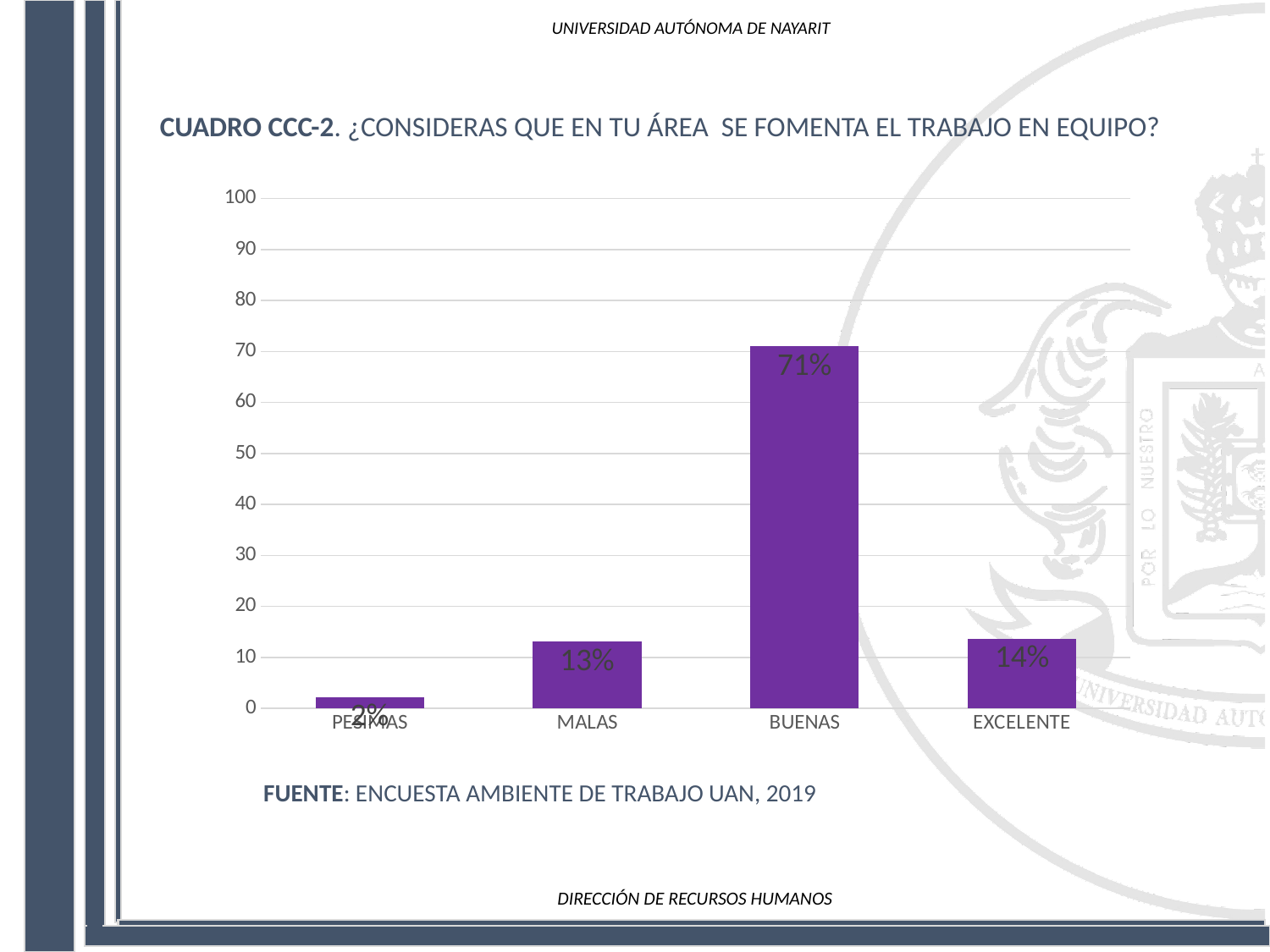
How many categories are shown on the x axis? 4 What is the value for EXCELENTE? 14% Which is larger, the value for MALAS or the value for BUENAS? BUENAS What is the value for PÉSIMAS? 2% What is the value for BUENAS? 71% Which category has the lowest value? PESIMAS Is the value for BUENAS greater or less than 50? greater What is the difference between the values for BUENAS and EXCELENTE? 57% What is the value for MALAS? 13% What is the difference between the values for MALAS and PÉSIMAS? 11% Which category has the highest value? BUENAS What kind of chart is shown on the slide? bar chart